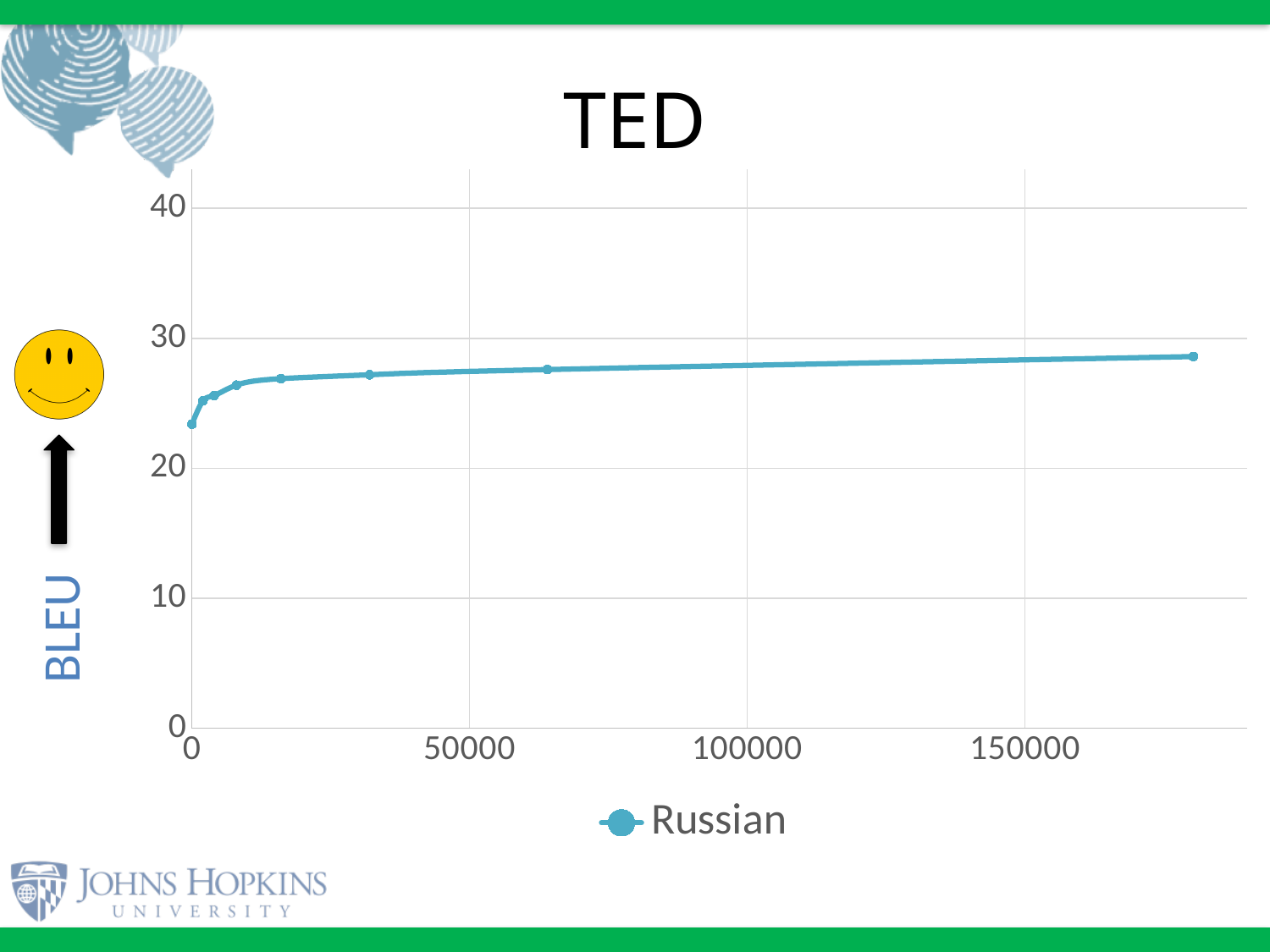
Is the BLEU value for Russian at the leftmost point (x = 0) greater or less than 30? less What kind of chart is shown on the slide? line chart What is the title of the chart? TED Is the BLEU value for Russian at the rightmost point greater or less than 20? greater Is the BLEU value for Russian at around x = 50000 greater or less than 20? greater Do the BLEU values for Russian rise or fall as the x-axis value increases? rise How many series does the legend list? 1 What series name appears in the legend? Russian Which is larger for Russian: the BLEU value at the leftmost point or at the rightmost point? the rightmost point